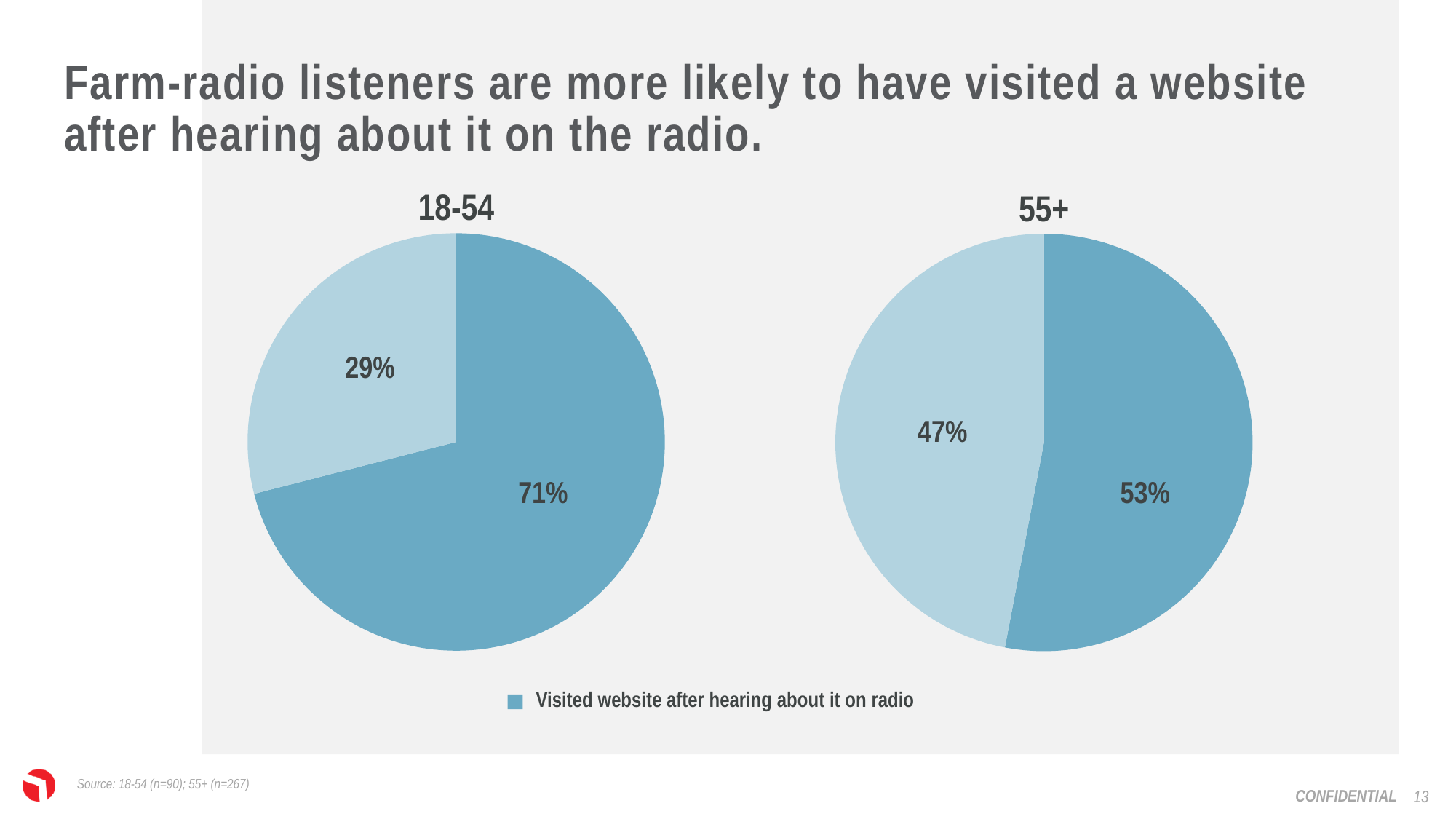
In the 55+ pie chart, what share of respondents visited a website after hearing about it on radio? 53% What type of charts are shown on the slide? Pie charts In the 18-54 pie chart, what is the value of the lighter slice? 29% In the 18-54 pie chart, which slice is larger, the 71% slice or the 29% slice? 71% How many slices does the 55+ pie chart have? 2 Which age group's pie chart shows the larger share that visited a website after hearing about it on radio, 18-54 or 55+? 18-54 How many pie charts are on the slide? 2 What is the difference between the 18-54 and 55+ shares that visited a website after hearing about it on radio? 18 percentage points In the 55+ pie chart, what is the value of the lighter slice? 47% What is the title of the pie chart on the right? 55+ What does the legend entry on the slide say? Visited website after hearing about it on radio In the 18-54 pie chart, what share of respondents visited a website after hearing about it on radio? 71%